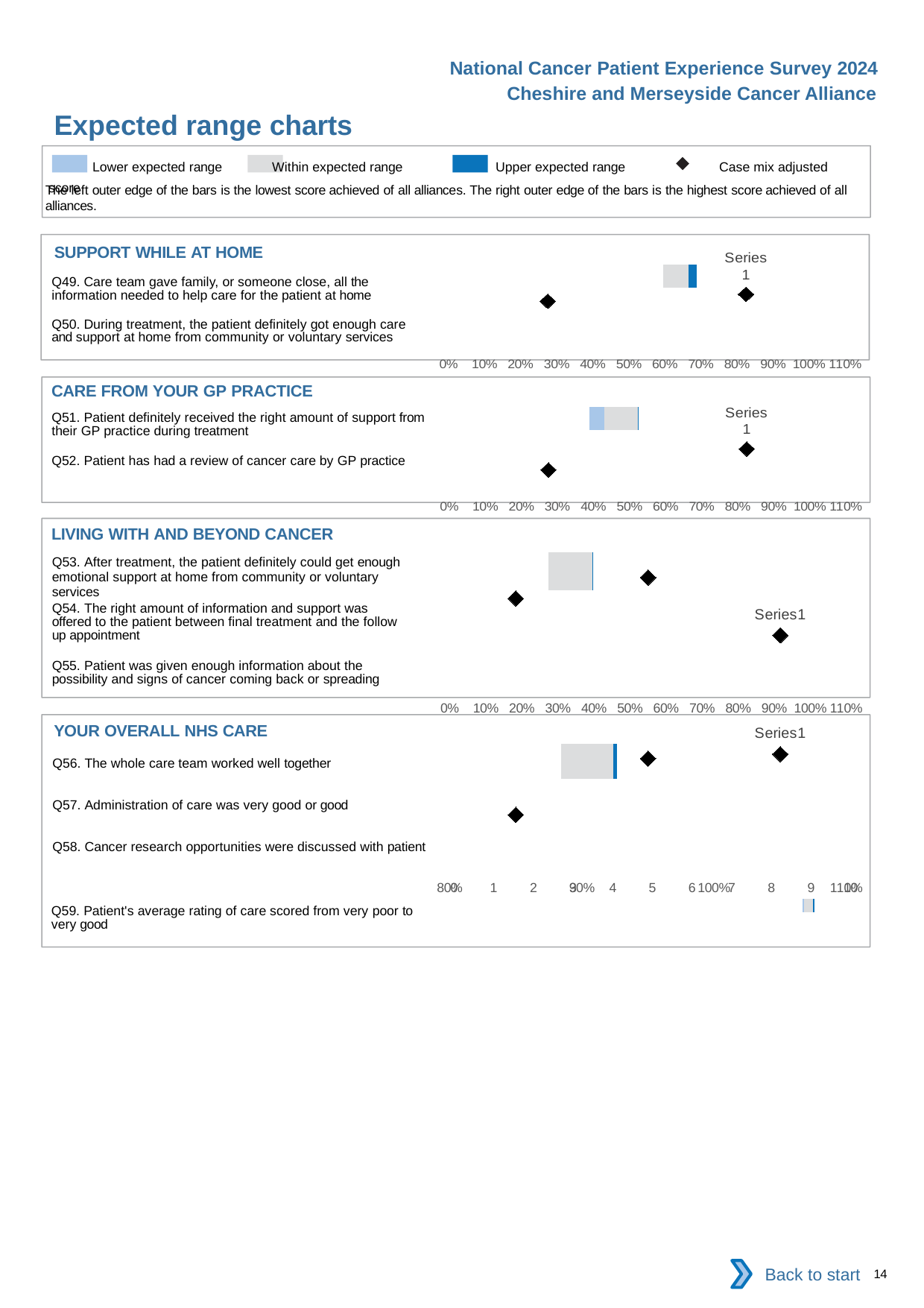
What is the highest tick label shown on the percentage axis of the SUPPORT WHILE AT HOME chart? 110% What is the title of the slide containing these charts? Expected range charts In the LIVING WITH AND BEYOND CANCER chart, how many questions are listed? 3 In the SUPPORT WHILE AT HOME chart, is the value of the leftmost diamond marker greater or less than 40%? less According to the legend, what does the diamond marker represent? Case mix adjusted score In the CARE FROM YOUR GP PRACTICE chart, is the value of the leftmost diamond marker greater or less than 50%? less In the SUPPORT WHILE AT HOME chart, how many questions are listed? 2 In the YOUR OVERALL NHS CARE chart, how many questions are listed? 4 How many entries does the legend at the top of the slide list? 4